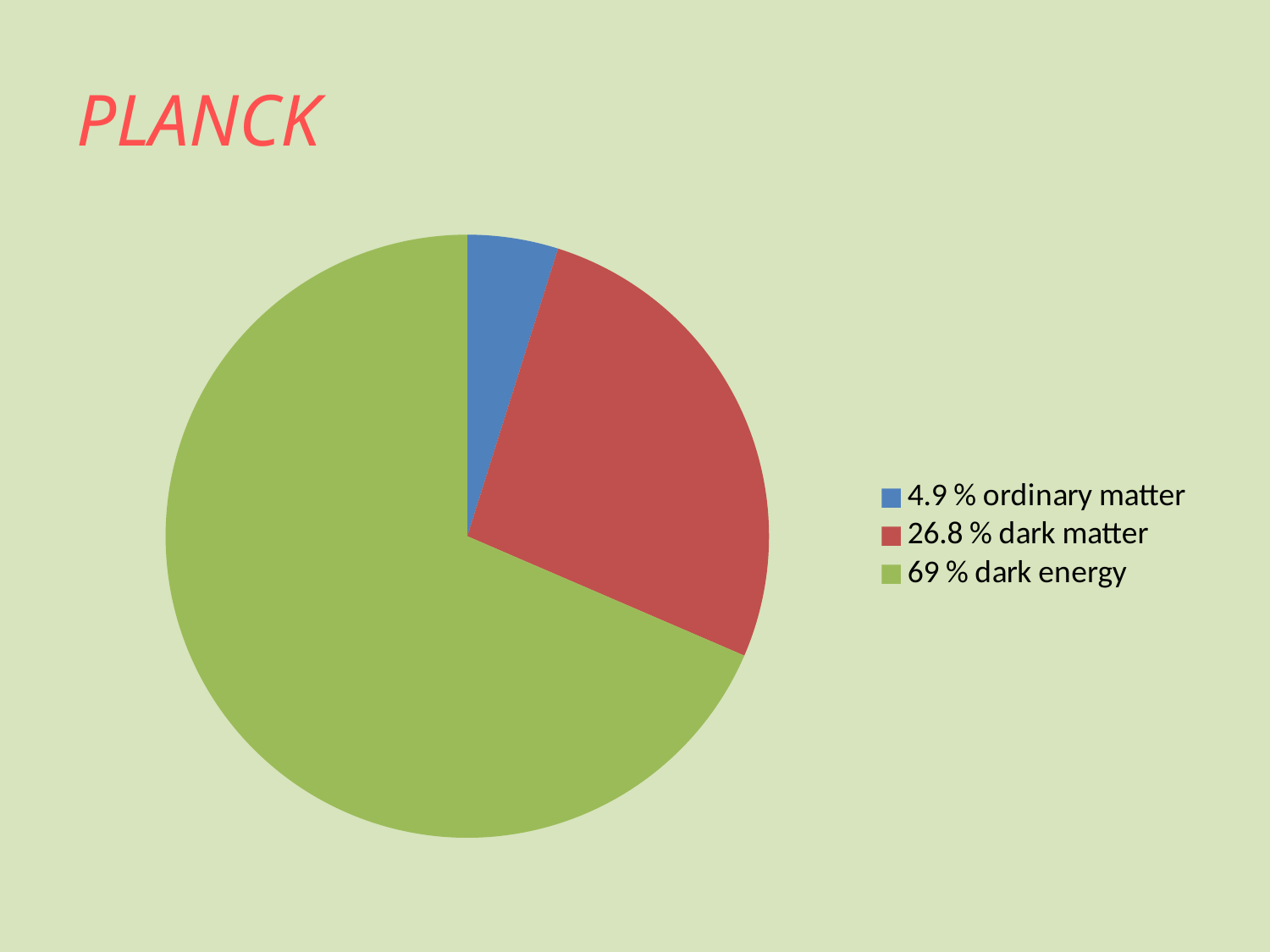
What percentage does the legend give for dark energy? 69 % What colour is the dark energy slice in the pie chart? green What kind of chart is shown on the slide? pie chart Which component has the largest slice of the pie chart? dark energy By how many percentage points does dark energy exceed dark matter in the pie chart? 42.2 What percentage does the legend give for ordinary matter? 4.9 % How many slices does the pie chart have? 3 What percentage does the legend give for dark matter? 26.8 % Which is larger in the pie chart, dark matter or ordinary matter? dark matter Which component has the smallest slice of the pie chart? ordinary matter How many entries does the legend of the pie chart list? 3 By how many percentage points does dark matter exceed ordinary matter in the pie chart? 21.9